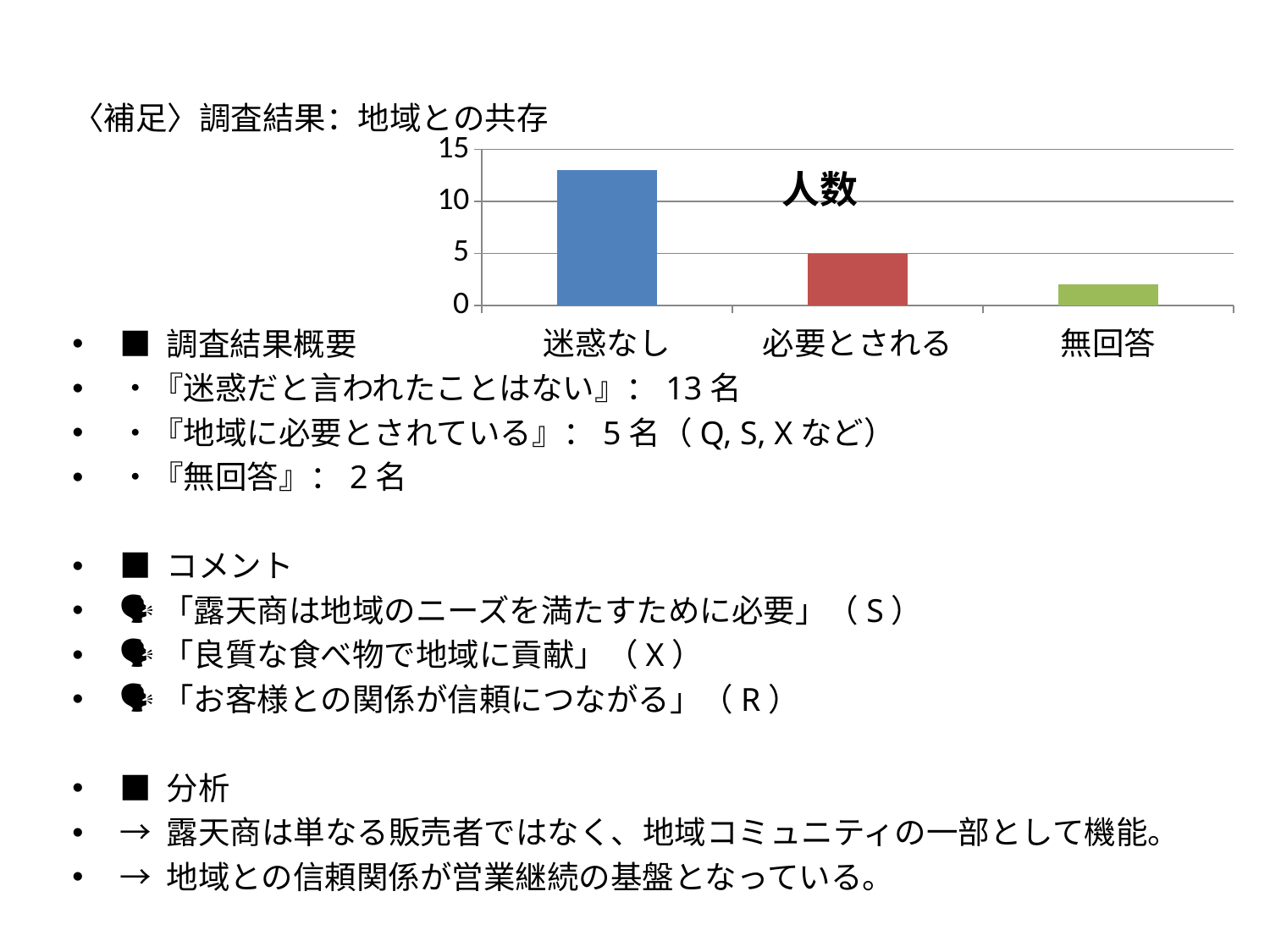
What is the value for 必要とされる in the chart? 5 What is the value for 迷惑なし in the chart? 13 Which is larger, the value for 必要とされる or the value for 無回答? 必要とされる Is the value for 迷惑なし greater or less than 10? greater Which category has the lowest value in the chart? 無回答 What kind of chart is shown on the slide? bar chart Which category has the highest value in the chart? 迷惑なし What is the difference between the values for 迷惑なし and 必要とされる? 8 How many categories are shown on the x axis of the chart? 3 Is the value for 無回答 greater or less than 5? less What is the value for 無回答 in the chart? 2 What is the title of the chart? 人数